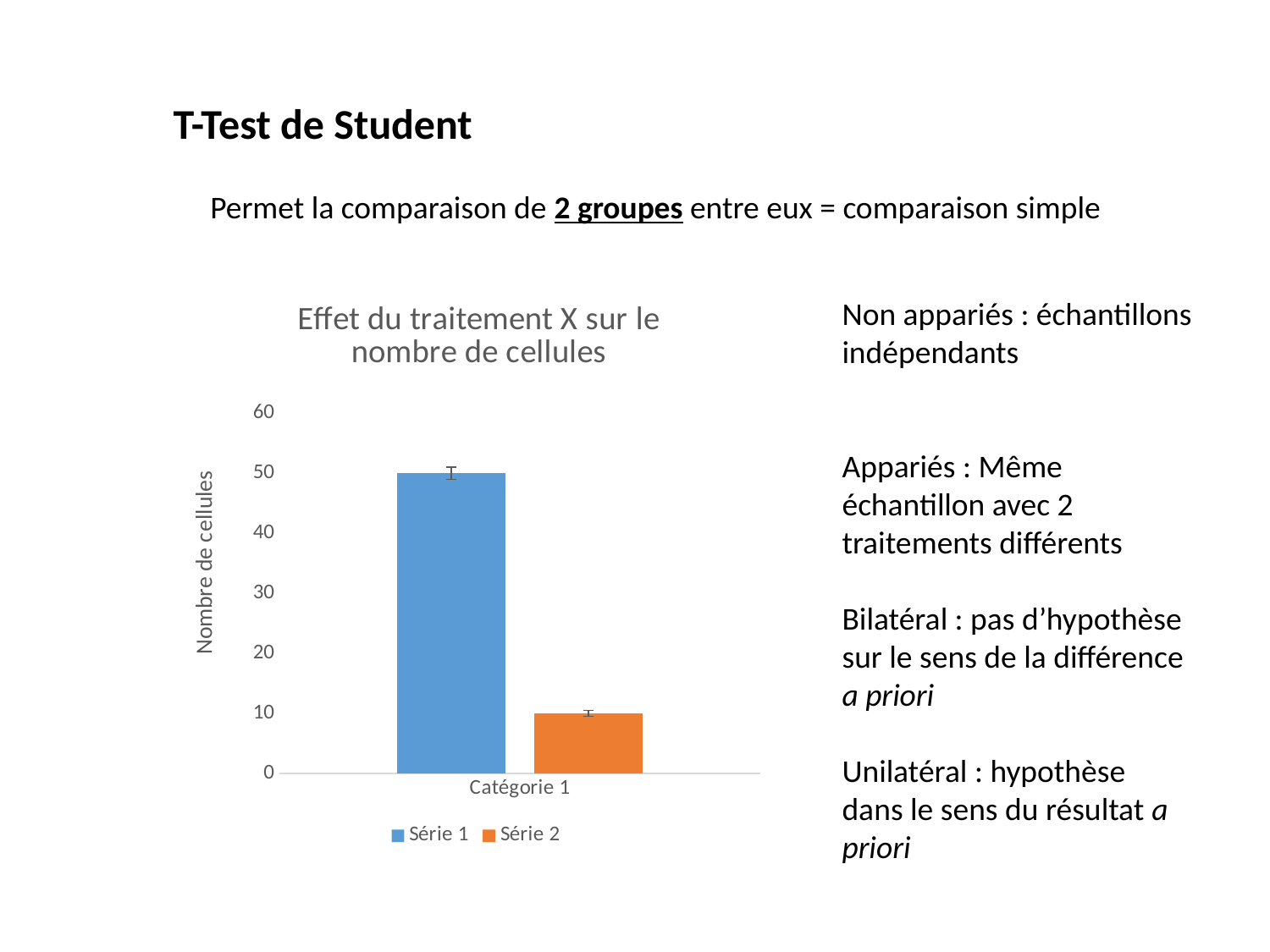
How many categories are shown on the x axis? 1 Is the value for Série 1 greater or less than 40? greater What is the value for Série 2 in Catégorie 1? 10 What is the difference between the Série 1 and Série 2 values? 40 What is the value for Série 1 in Catégorie 1? 50 Is the value for Série 2 greater or less than 20? less What kind of chart is shown on the slide? bar chart What is the title of the chart? Effet du traitement X sur le nombre de cellules Which series has the higher value in Catégorie 1? Série 1 How many series does the legend list? 2 Which series has the lower value in Catégorie 1? Série 2 Is the value for Série 1 larger or smaller than the value for Série 2? larger